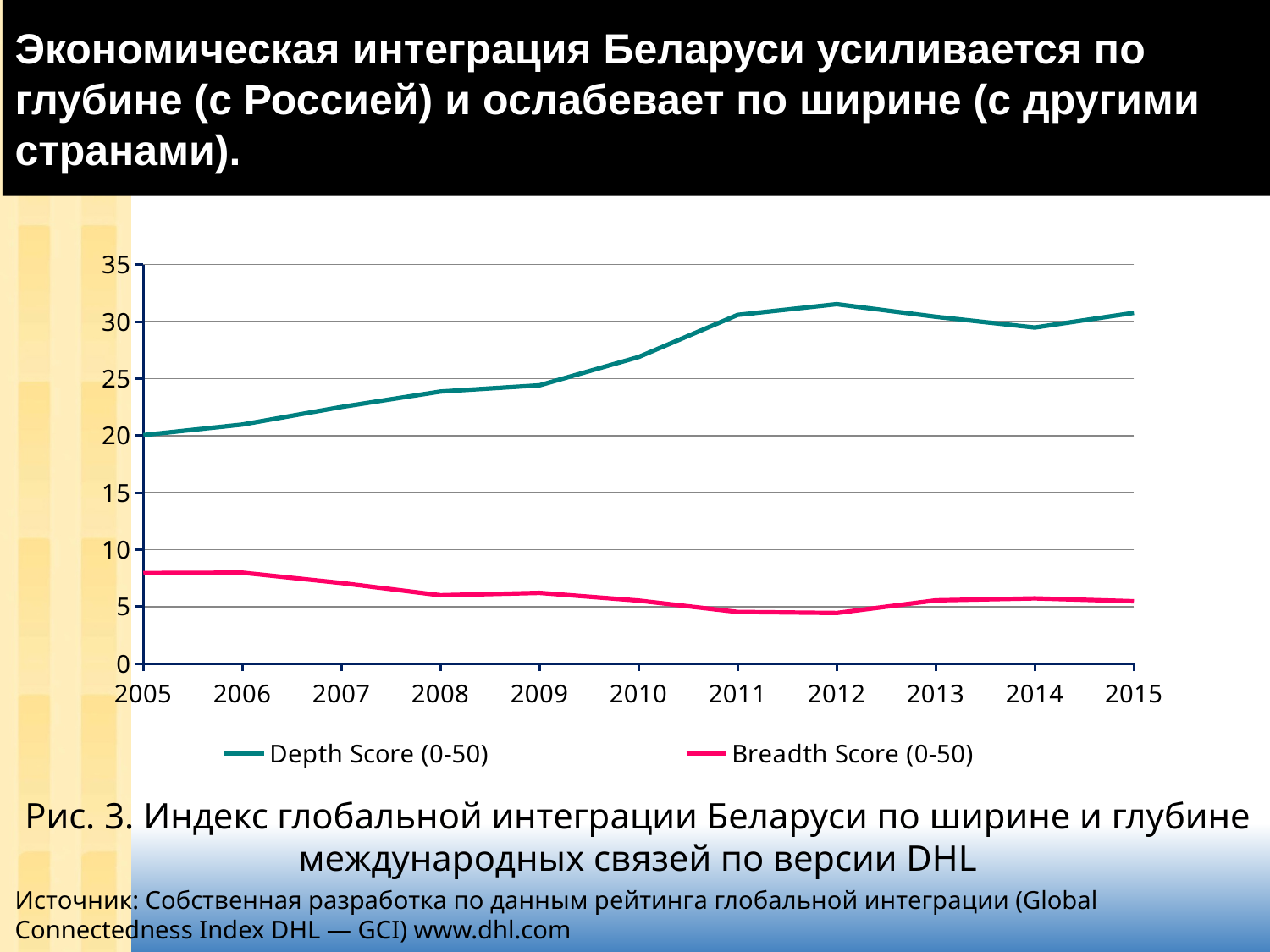
How many series does the legend list? 2 Is the Breadth Score (0-50) for 2005 greater or less than 5? greater What are the two series named in the legend? Depth Score (0-50) and Breadth Score (0-50) In which year is the Depth Score (0-50) highest? 2012 Does the Depth Score (0-50) generally rise or fall from 2005 to 2015? rise Is the Depth Score (0-50) for 2008 greater or less than 25? less How many years are plotted along the x axis? 11 In which year is the Depth Score (0-50) lowest? 2005 Is the Depth Score (0-50) for 2012 greater or less than 30? greater What kind of chart is shown on the slide? line chart In 2010, which is larger: the Depth Score (0-50) or the Breadth Score (0-50)? Depth Score (0-50)